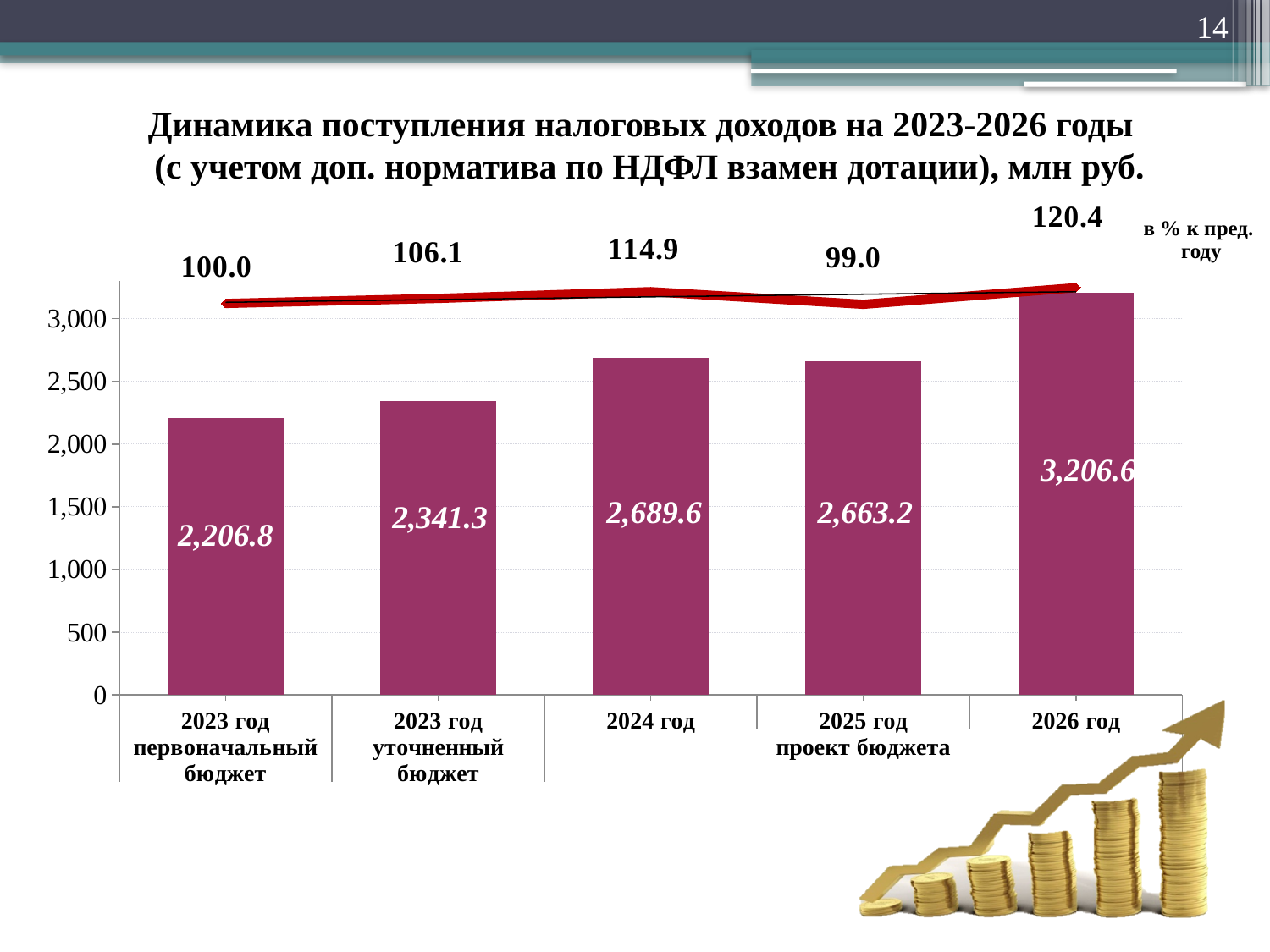
Which category has the highest value? 2026 год What is the value for 2024 год? 2,689.6 What is the difference between the values for 2026 год and 2025 год проект бюджета? 543.4 What is the value for 2023 год первоначальный бюджет? 2,206.8 What is the unit of measurement stated in the chart title? млн руб. What percentage to the previous year (в % к пред. году) is shown above the 2025 год проект бюджета bar? 99.0 How many categories are shown on the x axis? 5 What is the value for 2026 год? 3,206.6 Which is larger, the value for 2024 год or the value for 2025 год проект бюджета? 2024 год Which category has the lowest value? 2023 год первоначальный бюджет What kind of chart is this? combination bar and line chart What is the difference between the values for 2023 год уточненный бюджет and 2023 год первоначальный бюджет? 134.5